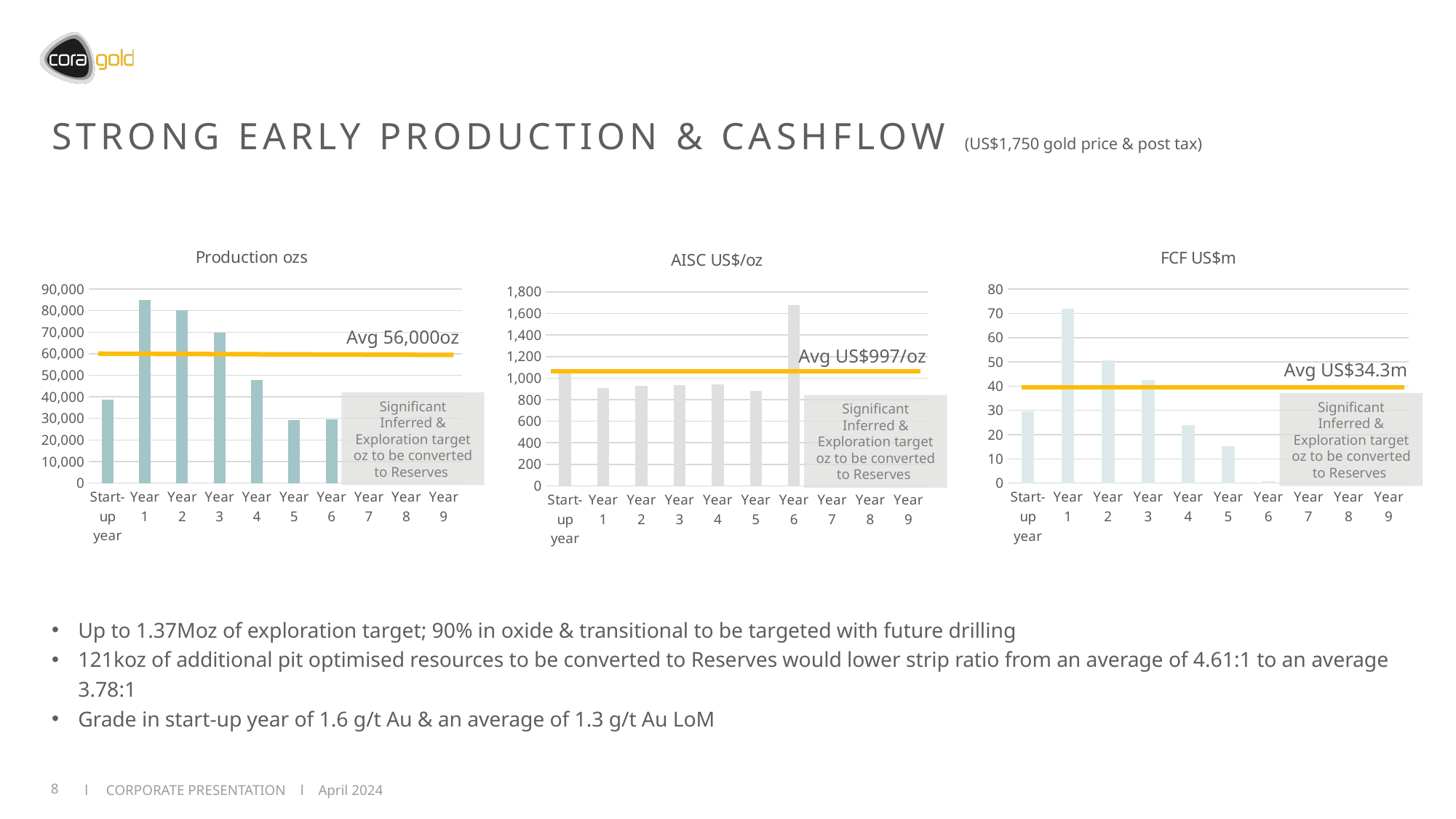
On the AISC US$/oz chart, what average value is printed next to the horizontal line? Avg US$997/oz On the Production ozs chart, how many categories are shown on the x axis? 10 On the FCF US$m chart, is the value for Year 5 greater or less than 20? less On the AISC US$/oz chart, which year has the highest AISC? Year 6 On the FCF US$m chart, what average value is printed next to the horizontal line? Avg US$34.3m What kind of chart is the FCF US$m chart? bar chart On the Production ozs chart, which year has the highest production? Year 1 On the FCF US$m chart, which year has the highest free cash flow? Year 1 On the AISC US$/oz chart, is the value for Year 6 greater or less than 1,600? greater On the Production ozs chart, which is larger, the value for Year 4 or the value for Year 5? Year 4 On the Production ozs chart, is the value for Year 1 greater or less than 80,000? greater On the Production ozs chart, what average value is printed next to the horizontal line? Avg 56,000oz